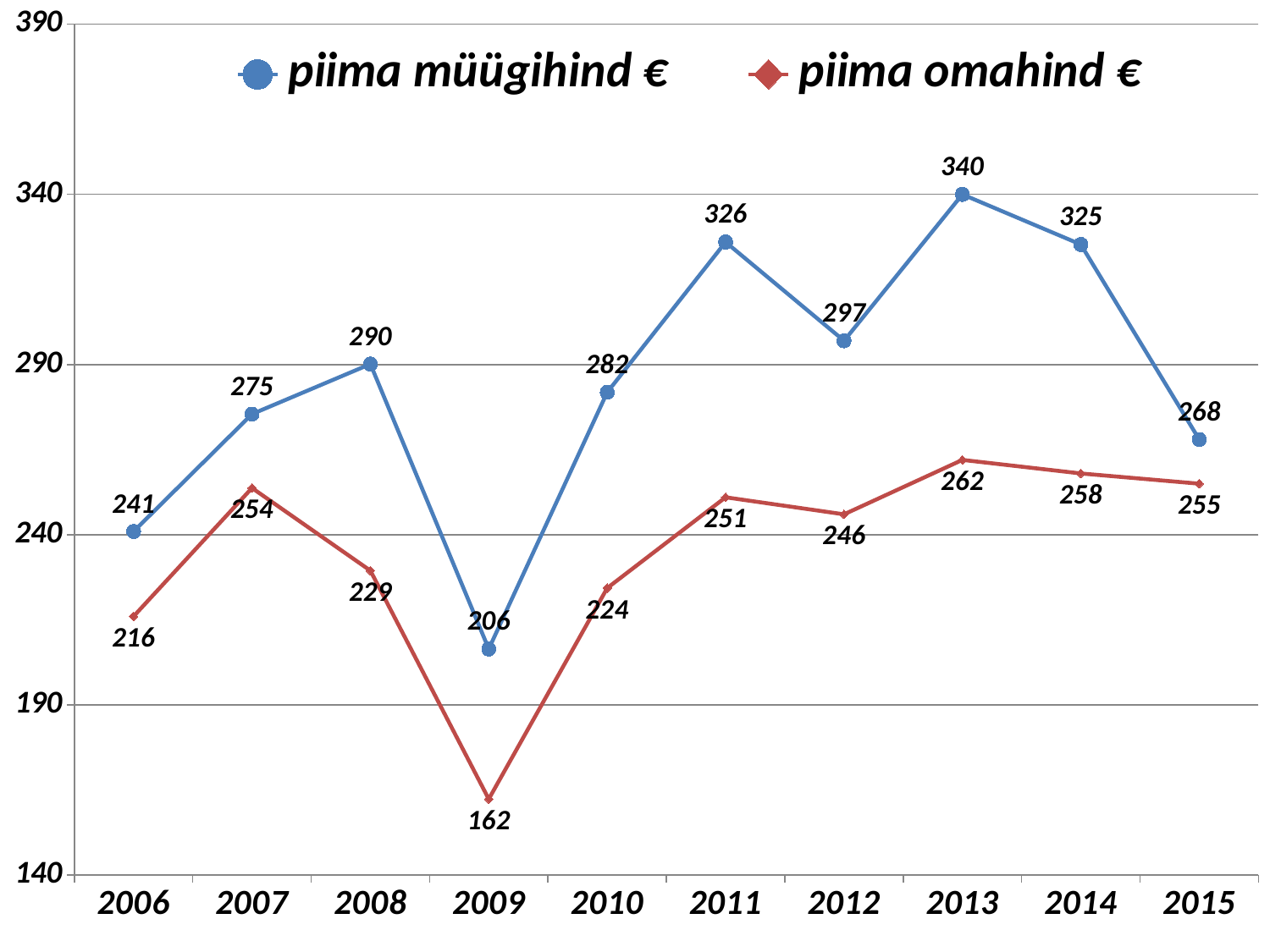
How many series does the legend list? 2 How many years are shown on the x axis? 10 Does piima müügihind € rise or fall from 2013 to 2015? fall Which is larger in 2015: piima müügihind € or piima omahind €? piima müügihind € In which year is piima omahind € highest? 2013 In which year is piima müügihind € lowest? 2009 What colour is the line for piima omahind €? red What is the value of piima omahind € in 2009? 162 Is the value of piima müügihind € in 2011 greater or less than 290? greater What is the value of piima müügihind € in 2013? 340 What kind of chart is this? line chart What is the difference between piima müügihind € and piima omahind € in 2013? 78